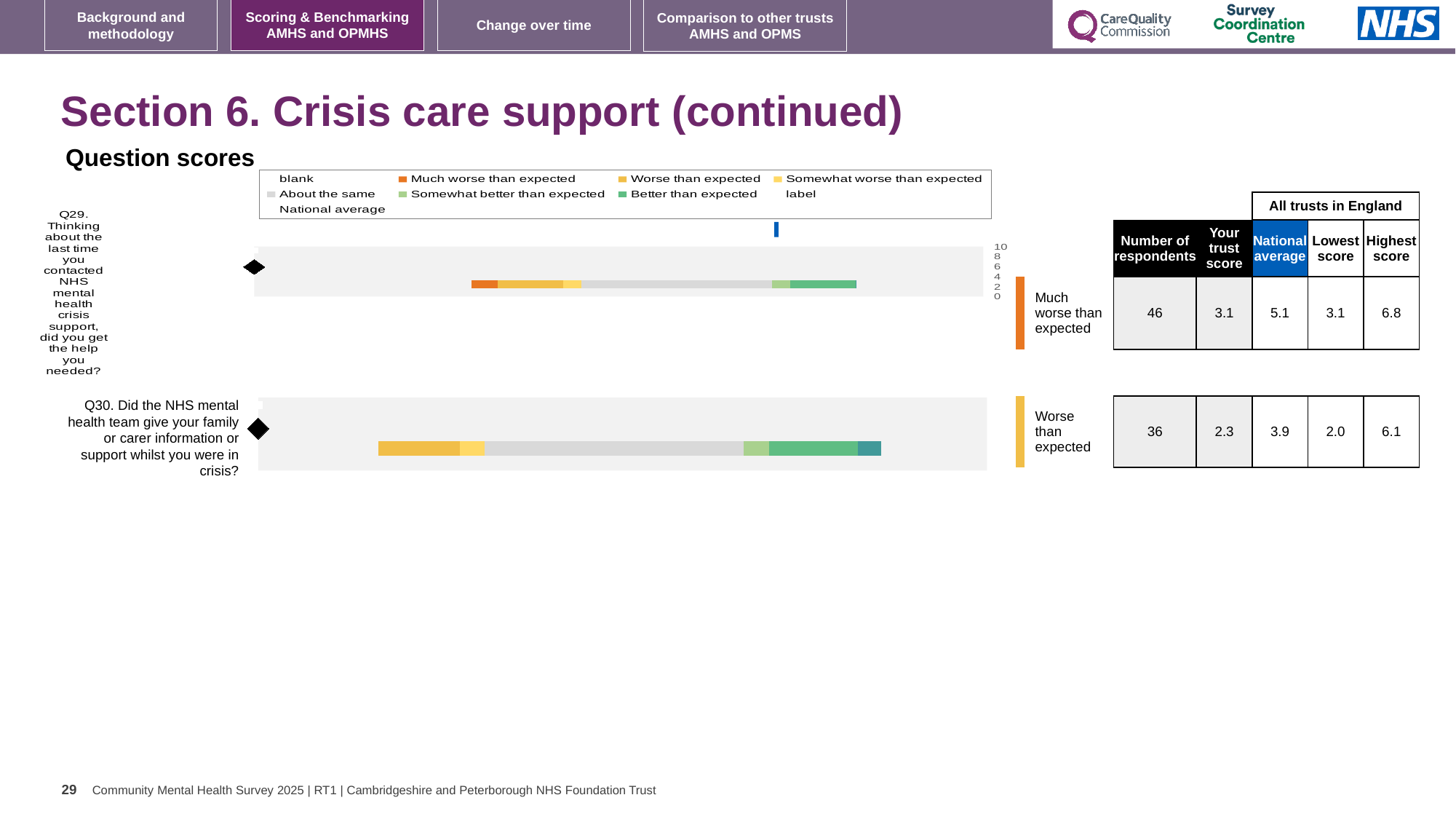
Which is larger for Q29, the trust score or the national average? National average What is the difference between the highest and lowest scores for Q30? 4.1 Which colour represents 'Much worse than expected' in the legend? Orange How many questions (bars) are plotted on the slide? 2 What kind of chart is used to show the question scores for Q29 and Q30? Bar chart What is the national average for Q30? 3.9 How many respondents answered Q29? 46 What is the lowest score among all trusts in England for Q29? 3.1 What is the difference between the national average and the trust score for Q29? 2.0 Which benchmark category is the Q30 bar labelled with? Worse than expected What is the trust score for Q29 shown next to the chart? 3.1 What is the highest score among all trusts in England for Q30? 6.1